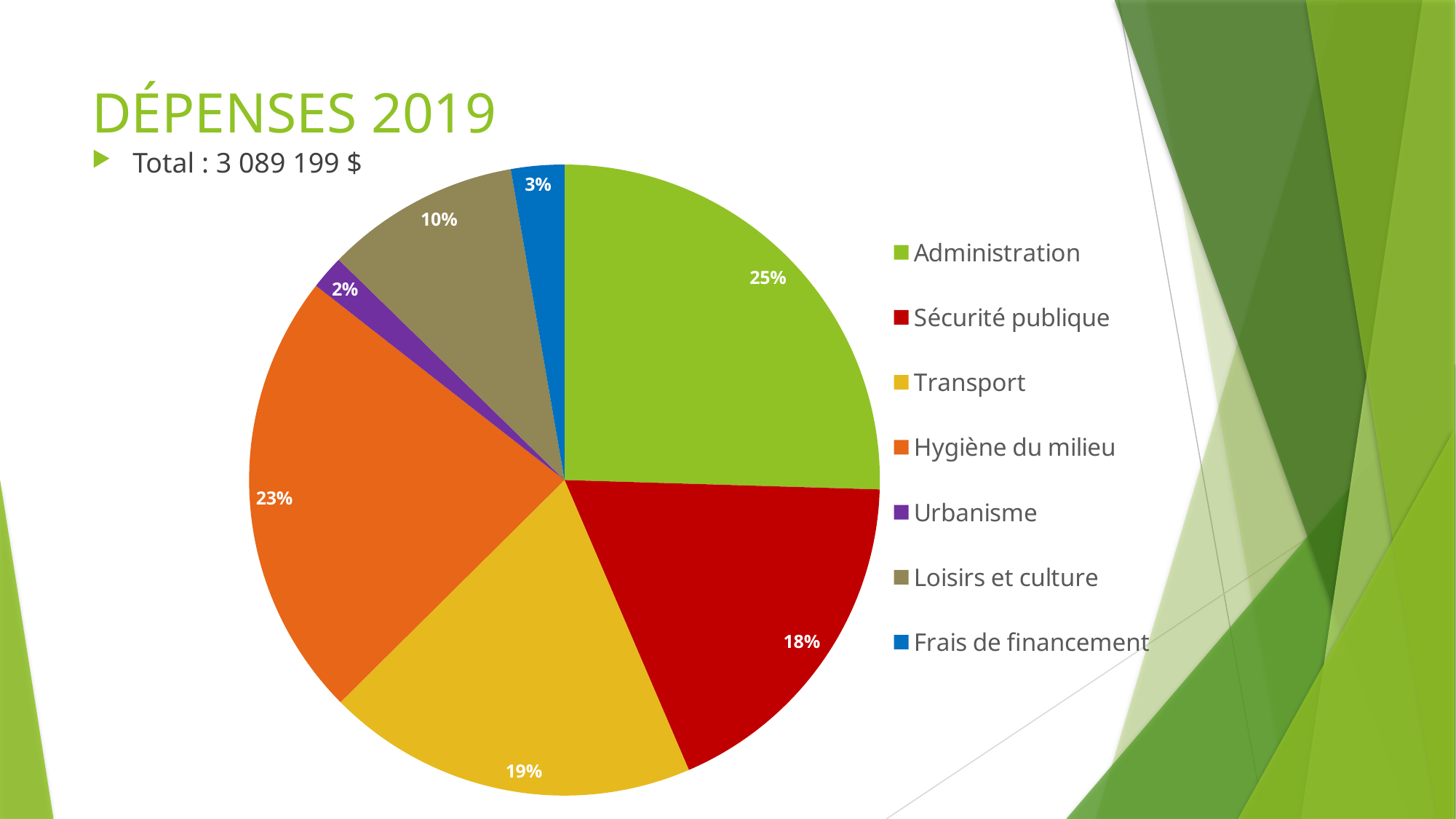
What is the value shown for Sécurité publique? 18% Which category has the largest slice of the pie? Administration How many categories does the pie chart have? 7 What is the difference in percentage points between Hygiène du milieu and Frais de financement? 20 Which is larger, the slice for Transport or the slice for Loisirs et culture? Transport What share of the pie does Hygiène du milieu represent? 23% What share of the pie does Administration represent? 25% What is the value shown for Loisirs et culture? 10% What is the value shown for Transport? 19% Which category has the smallest slice of the pie? Urbanisme What is the title of the slide containing the chart? DÉPENSES 2019 What kind of chart is shown on the slide? pie chart